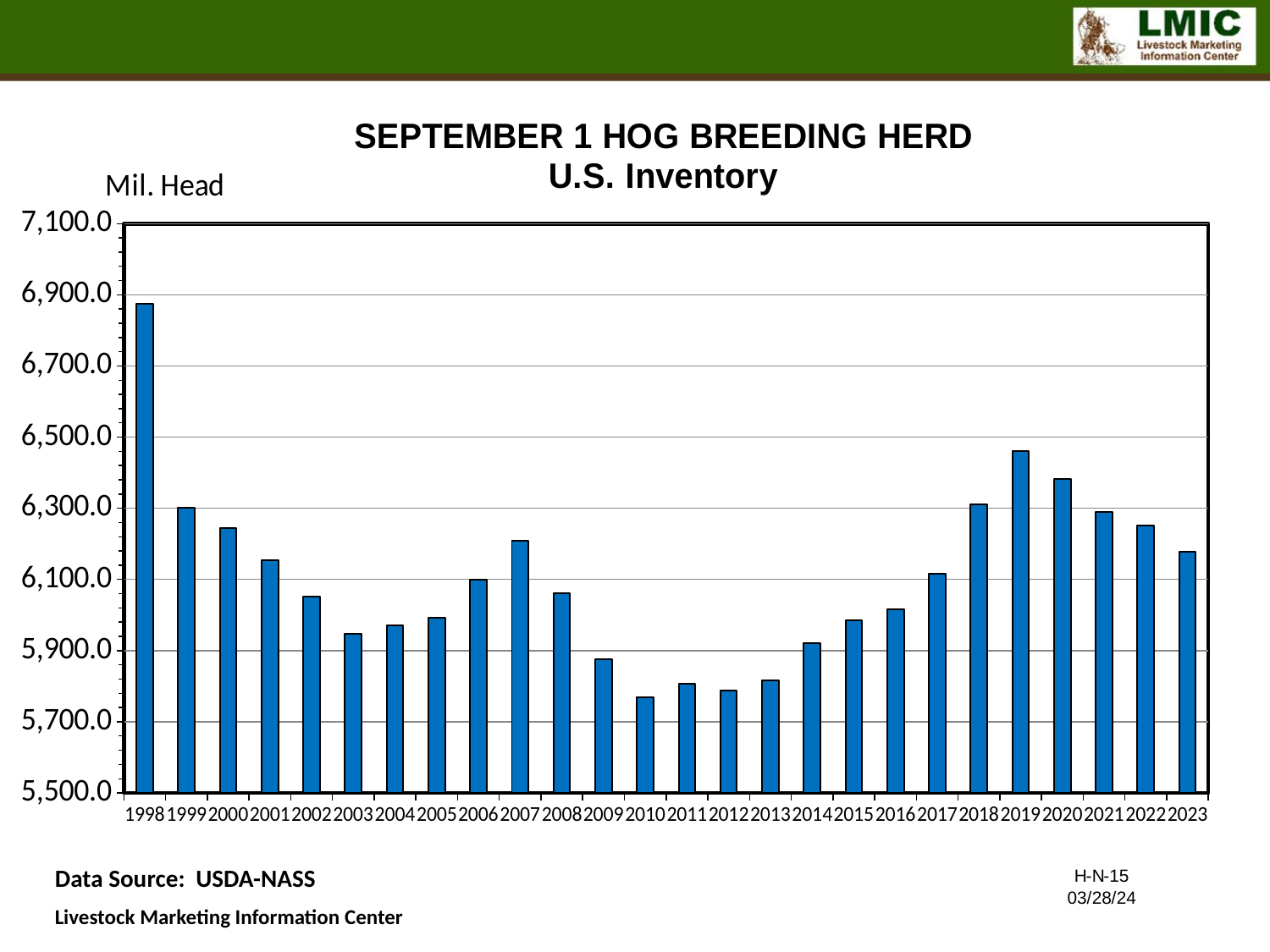
Which year has the lowest September 1 hog breeding herd inventory? 2010 What kind of chart is shown on the slide? bar chart How many years are plotted on the x axis? 26 Do the values rise or fall from 2010 to 2019? rise Which is larger, the value for 2007 or the value for 2008? 2007 Is the value for 2010 greater or less than 5,900.0? less Which is larger, the value for 2019 or the value for 2020? 2019 Is the value for 1998 greater or less than 6,700.0? greater Is the value for 2003 greater or less than 6,100.0? less Which year has the highest September 1 hog breeding herd inventory? 1998 What unit is shown on the y axis label? Mil. Head